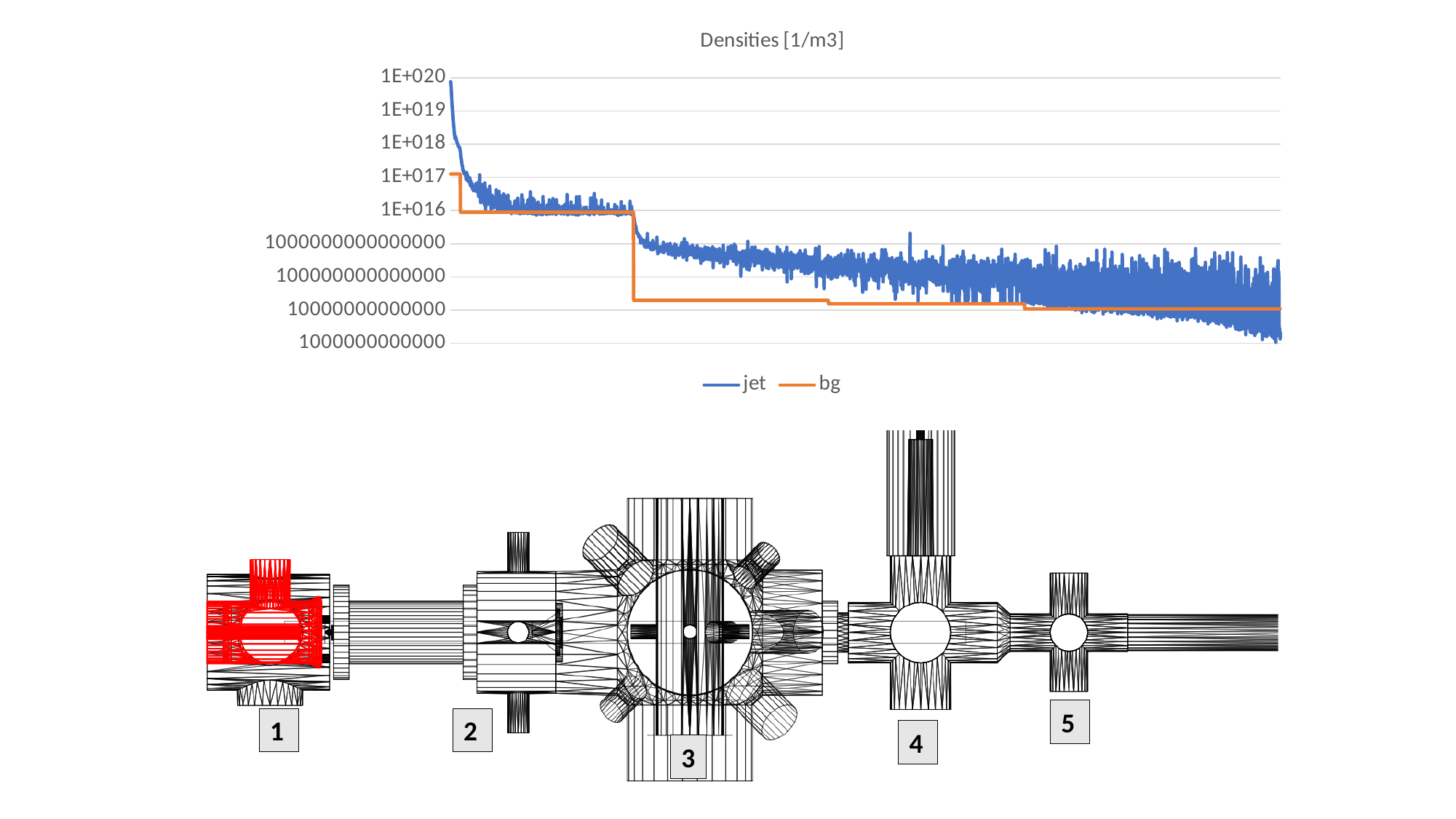
Around the middle of the x axis, which series has the higher value, jet or bg? jet Does the bg series rise or fall overall from left to right along the x axis? fall At the far left of the chart, is the jet value greater or less than 1E+019? greater Does the jet series rise or fall overall from left to right along the x axis? fall At the far left of the chart, which series has the higher value, jet or bg? jet What is the title of the chart? Densities [1/m3] How many series does the chart legend list? 2 What are the names of the two series in the legend? jet and bg What is the highest value labelled on the y axis? 1E+020 How many tick labels are shown on the y axis? 9 At the far right of the chart, is the bg value greater or less than 1E+016? less What kind of chart is shown on the slide? line chart